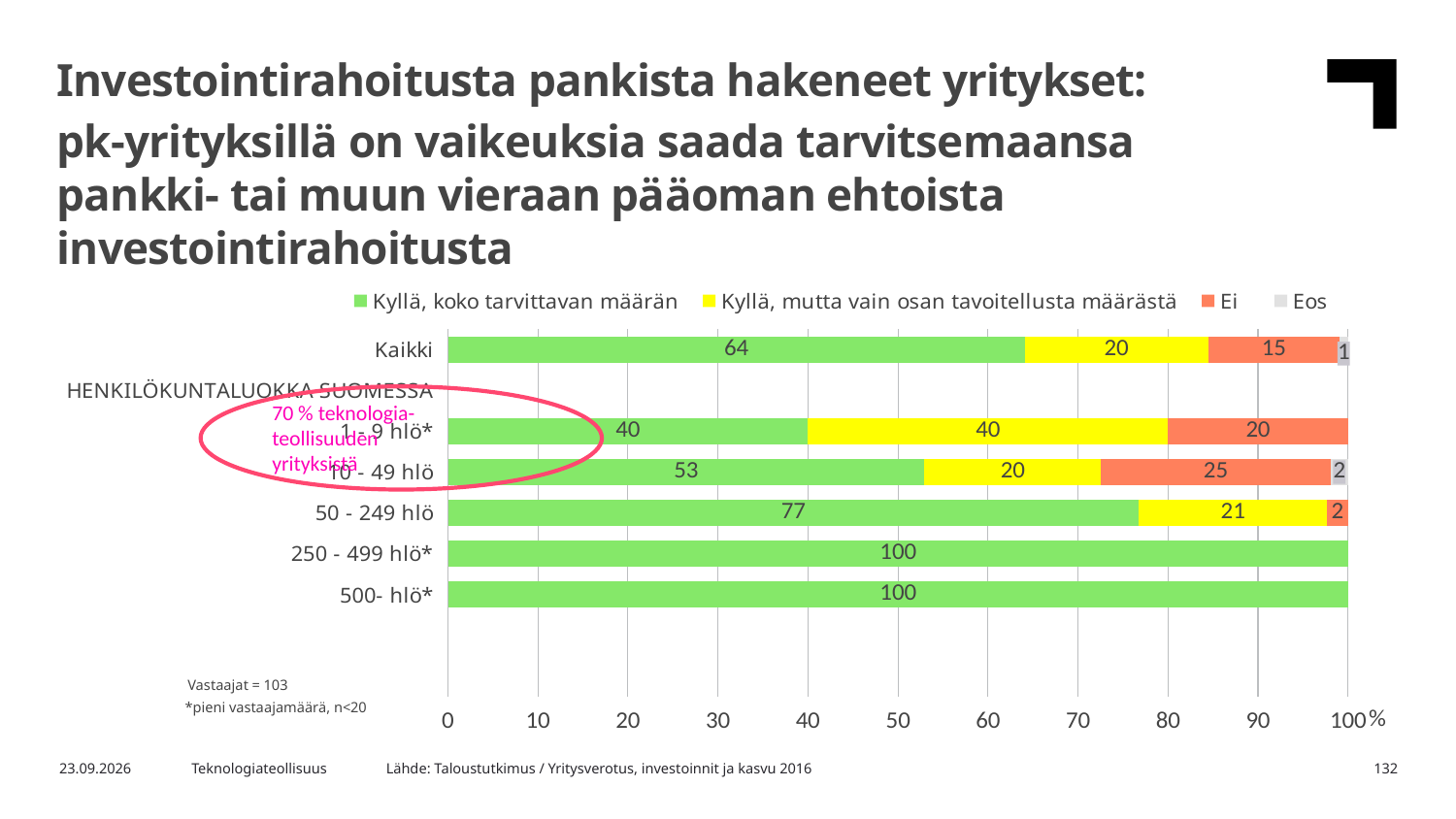
Which is larger: the 'Ei' value for 1 - 9 hlö* or for Kaikki? 1 - 9 hlö* Which category has the lowest value for 'Kyllä, koko tarvittavan määrän'? 1 - 9 hlö* What is the value of 'Kyllä, koko tarvittavan määrän' for the 250 - 499 hlö* category? 100 What is the difference between the 'Kyllä, koko tarvittavan määrän' values for 50 - 249 hlö and 10 - 49 hlö? 24 What is the value of 'Ei' for the 10 - 49 hlö category? 25 What is the value of 'Kyllä, koko tarvittavan määrän' for the Kaikki category? 64 What kind of chart is shown on the slide? Stacked bar chart How many series does the legend list? 4 What is the value of 'Kyllä, mutta vain osan tavoitellusta määrästä' for the 50 - 249 hlö category? 21 How many categories are shown on the vertical axis of the chart? 6 What colour represents the 'Ei' series in the chart? Orange What is the total of the stacked bar for the 10 - 49 hlö category? 100